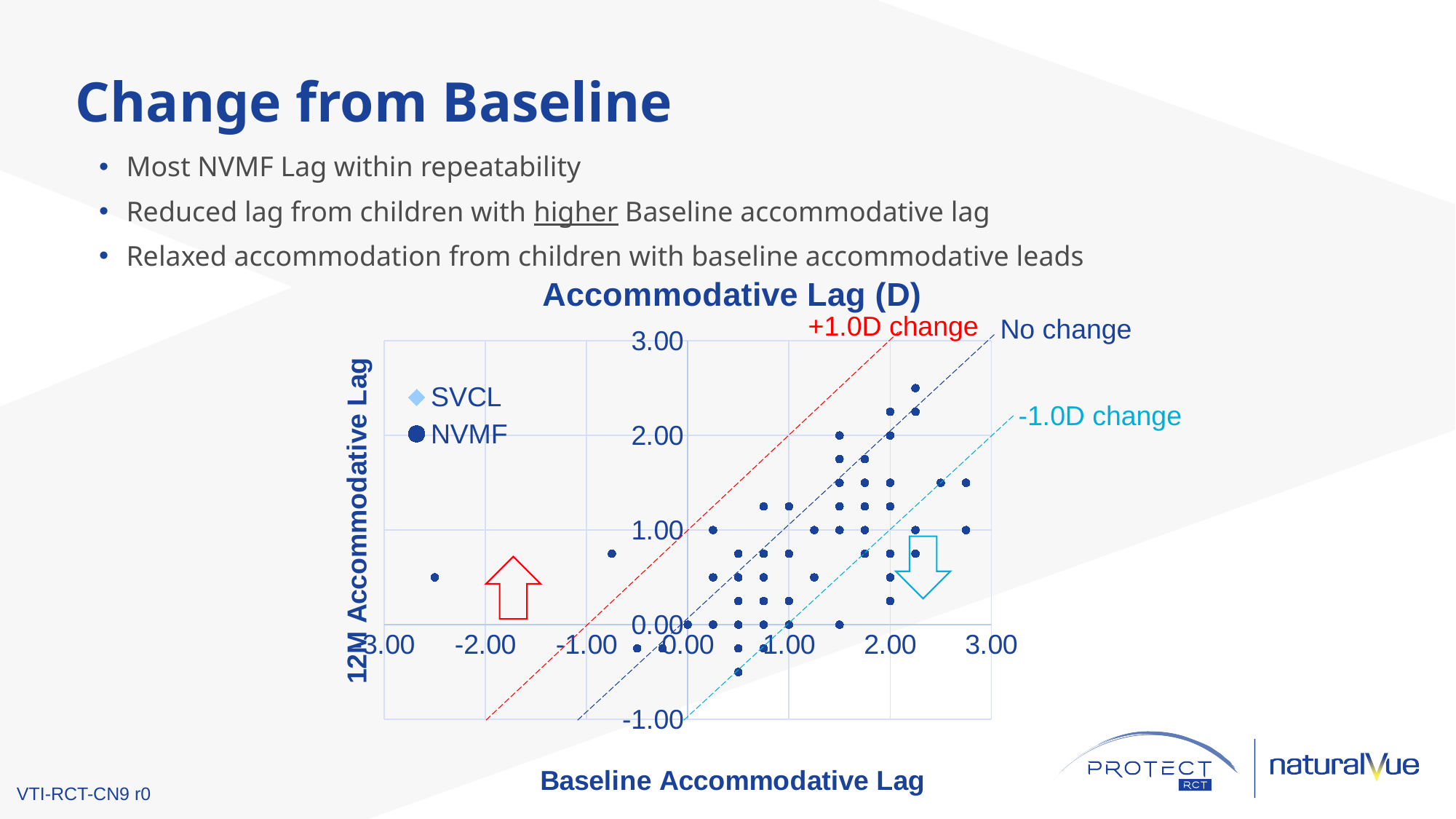
What kind of chart is shown on the slide? Scatter chart What are the two series named in the chart legend? SVCL and NVMF How many dashed reference lines are drawn on the chart? 3 How many series does the chart legend list? 2 Is the lowest plotted Baseline Accommodative Lag value greater or less than -2.00? less What is the title of the chart? Accommodative Lag (D) Is the highest plotted 12M Accommodative Lag value greater or less than 3.00? less